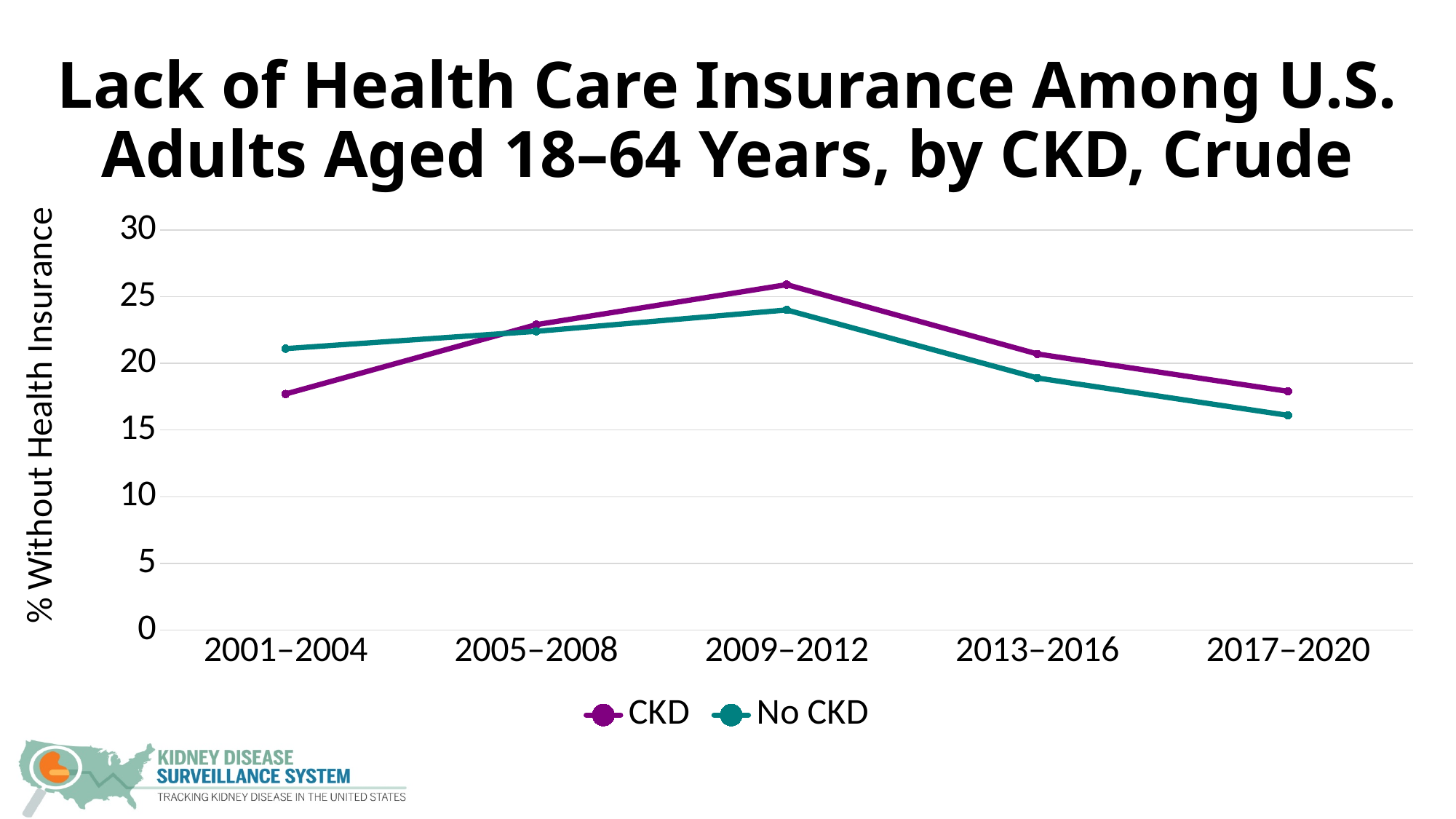
Is the value for No CKD in 2013–2016 greater or less than 20? less How many series does the legend list? 2 Does the No CKD series rise or fall from 2009–2012 to 2017–2020? Fall What kind of chart is shown on the slide? Line chart How many time periods are shown on the x axis? 5 In which period does the CKD series reach its highest value? 2009–2012 In which period does the No CKD series reach its lowest value? 2017–2020 Is the value for CKD in 2009–2012 greater or less than 25? greater In 2001–2004, which series has the higher value, CKD or No CKD? No CKD In 2017–2020, which series has the higher value, CKD or No CKD? CKD What is the label on the y axis? % Without Health Insurance Is the value for CKD in 2001–2004 greater or less than 20? less